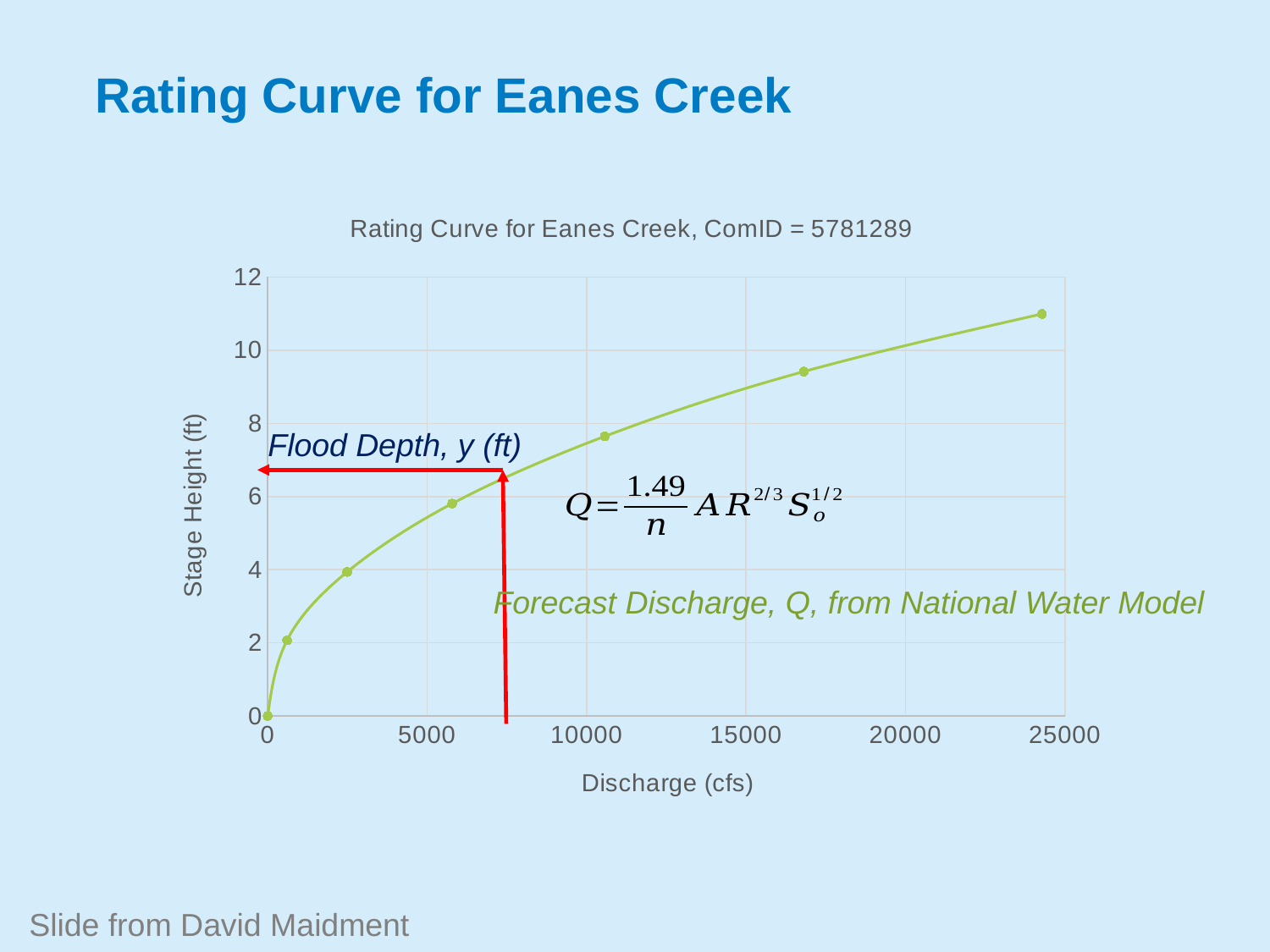
As discharge increases along the x axis, does stage height rise or fall? rise What is the title printed above the chart? Rating Curve for Eanes Creek, ComID = 5781289 Is the stage height of the second-highest point on the curve greater or less than 8? greater Which has the higher stage height: the point near 10000 cfs or the point near 17000 cfs? the point near 17000 cfs Is the discharge of the second-highest point on the curve greater or less than 15000? greater How many data points are plotted on the rating curve? 7 Is the stage height of the point plotted near 10000 cfs greater or less than 8? less What kind of chart is shown on the slide? line chart What is the largest value shown on the y axis (Stage Height)? 12 What is the label of the x axis of the chart? Discharge (cfs)